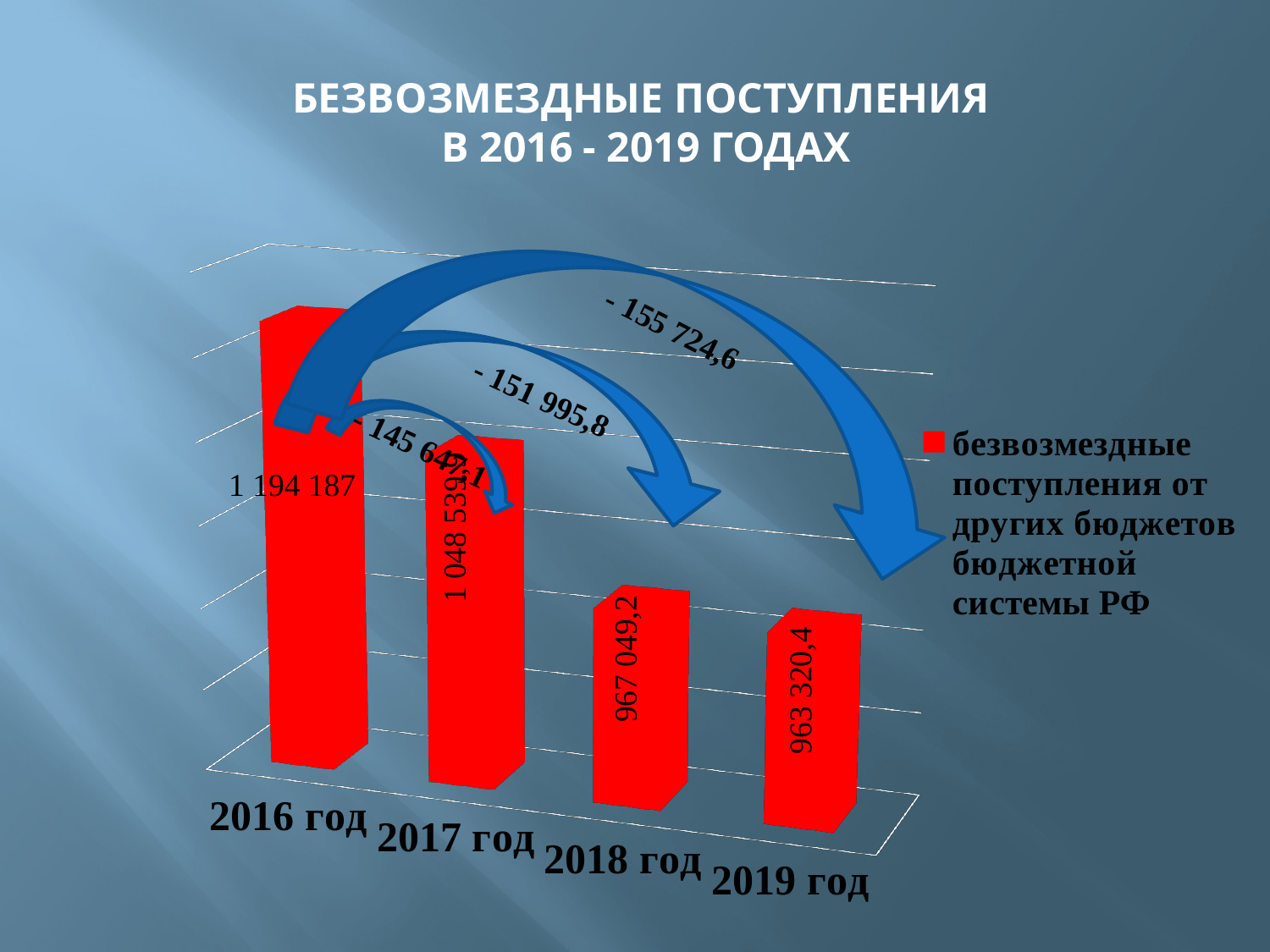
What is the value for 2019 год? 963 320,4 What colour are the bars in the chart? Red What is the difference between the values for 2018 год and 2019 год? 3 728,8 What kind of chart is shown on the slide? Bar chart What is the value for 2018 год? 967 049,2 What is the value for 2016 год? 1 194 187 How many years are shown on the x axis? 4 Which is larger, the value for 2018 год or for 2019 год? 2018 год Which year has the lowest value? 2019 год Which year has the highest value? 2016 год Do the values rise or fall from 2016 год to 2019 год? Fall How many series does the legend list? 1